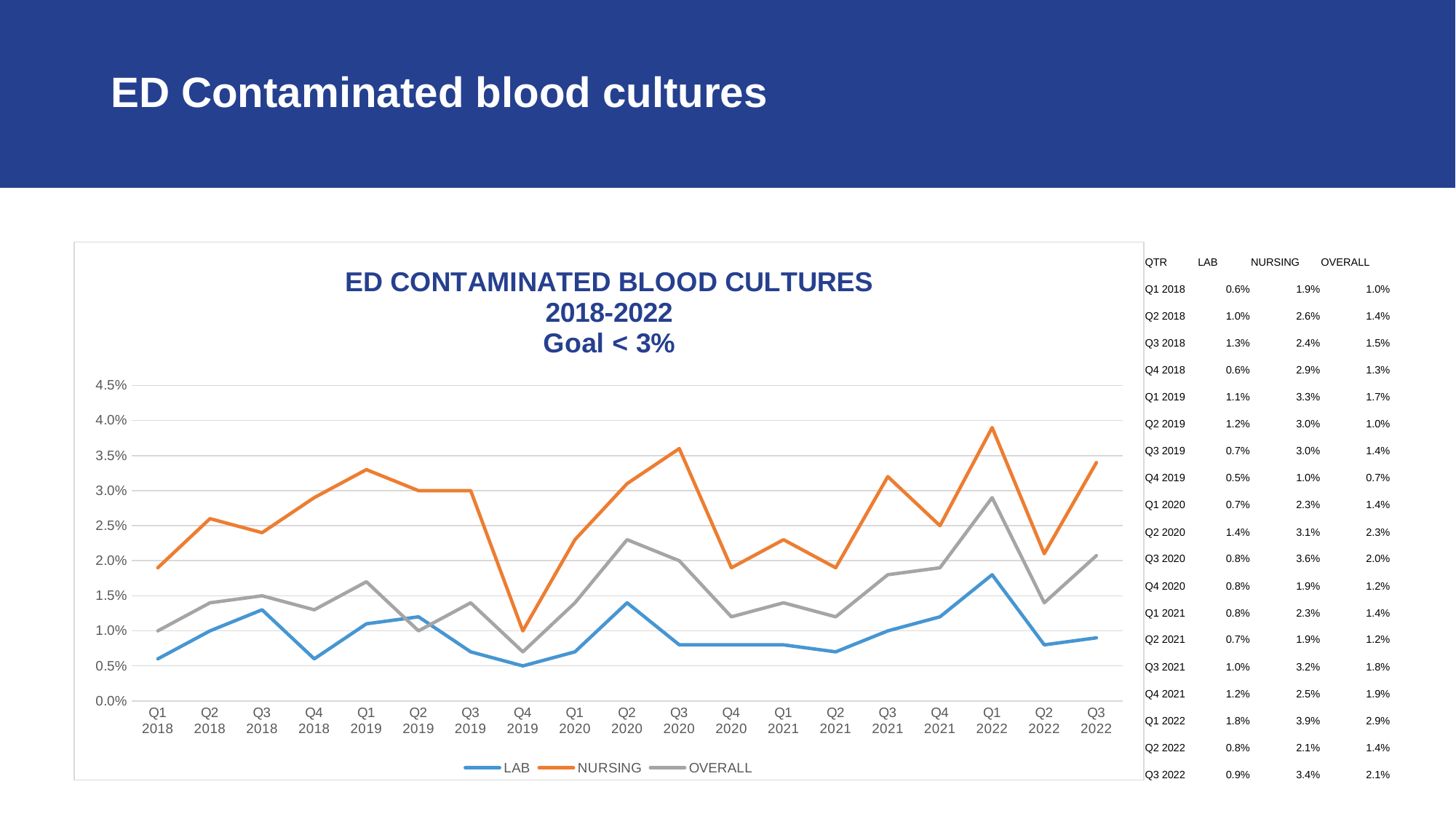
In which quarter does the NURSING series reach its highest value? Q1 2022 How many series does the chart legend list? 3 What is the difference between the NURSING and LAB values in Q1 2022? 2.1% What is the NURSING value for Q1 2022? 3.9% Is the NURSING value for Q3 2020 greater or less than 3.0%? greater What is the LAB value for Q4 2019? 0.5% What is the OVERALL value for Q3 2022? 2.1% How many quarters are plotted along the x axis of the chart? 19 Which is larger, the OVERALL value for Q2 2020 or the OVERALL value for Q3 2020? Q2 2020 What goal is stated in the chart title? Goal < 3% In which quarter does the NURSING series reach its lowest value? Q4 2019 What type of chart is shown on the slide? line chart